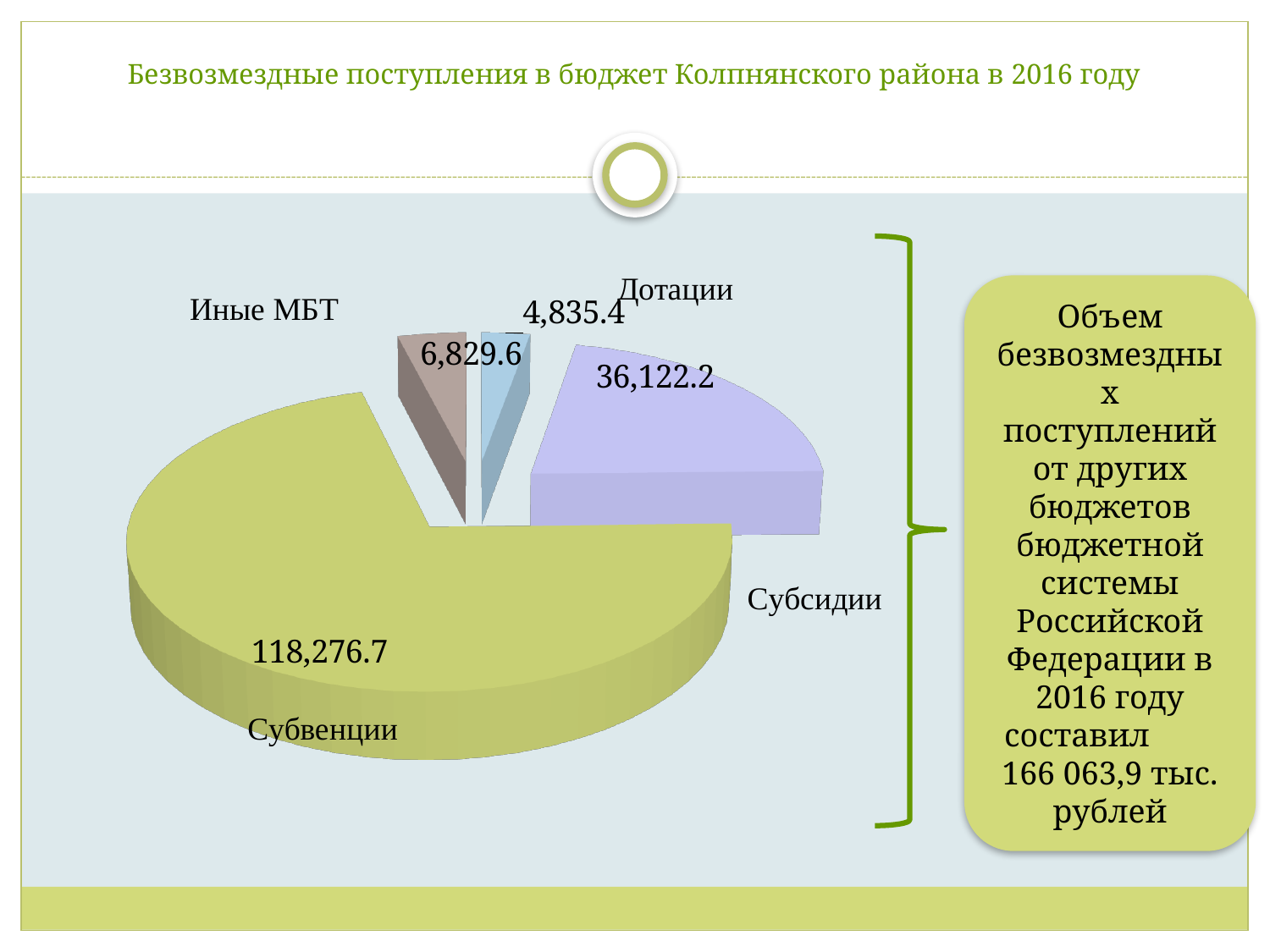
Which category has the smallest slice of the pie chart? Дотации Which category has the largest slice of the pie chart? Субвенции What is the value for Субвенции on the pie chart? 118,276.7 What is the value for Дотации on the pie chart? 4,835.4 How many categories are shown on the pie chart? 4 What kind of chart is shown on the slide? Pie chart What is the value for Субсидии on the pie chart? 36,122.2 What is the title of the slide containing the chart? Безвозмездные поступления в бюджет Колпнянского района в 2016 году What is the difference between the values for Иные МБТ and Дотации? 1,994.2 What is the difference between the values for Субвенции and Субсидии? 82,154.5 What is the value for Иные МБТ on the pie chart? 6,829.6 Which is larger, the value for Субсидии or the value for Иные МБТ? Субсидии